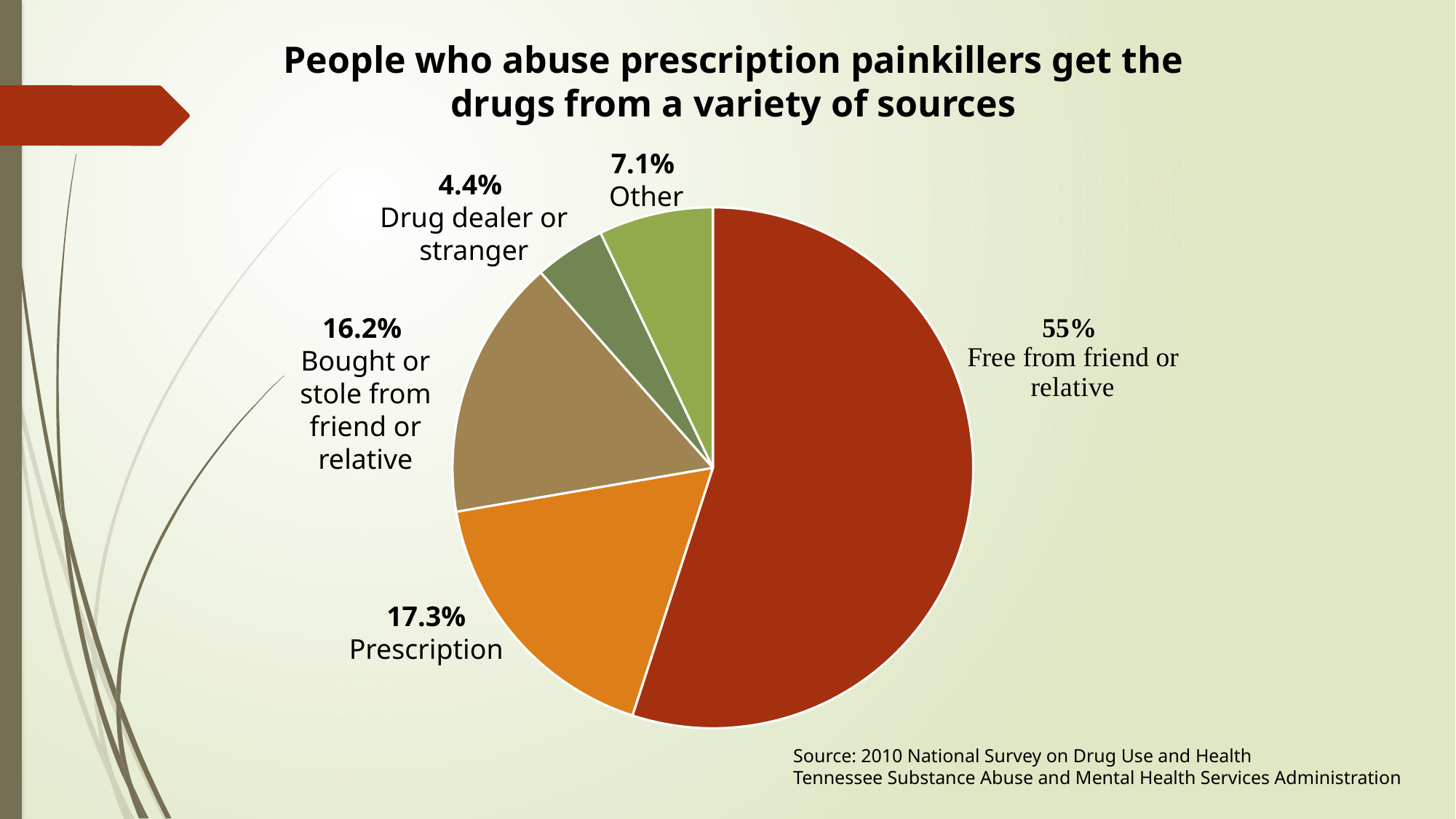
How many slices does the pie chart have? 5 What kind of chart is shown on the slide? Pie chart What percentage is shown for the "Prescription" slice? 17.3% Which source has the smallest share of the pie? Drug dealer or stranger What percentage is shown for the "Other" slice? 7.1% What percentage is shown for "Drug dealer or stranger"? 4.4% What is the title of the chart on the slide? People who abuse prescription painkillers get the drugs from a variety of sources Which is larger, the share for "Other" or the share for "Drug dealer or stranger"? Other What share of the pie is labelled "Free from friend or relative"? 55% Which source has the largest share of the pie? Free from friend or relative What is the difference in percentage points between "Prescription" and "Bought or stole from friend or relative"? 1.1 What percentage is shown for "Bought or stole from friend or relative"? 16.2%